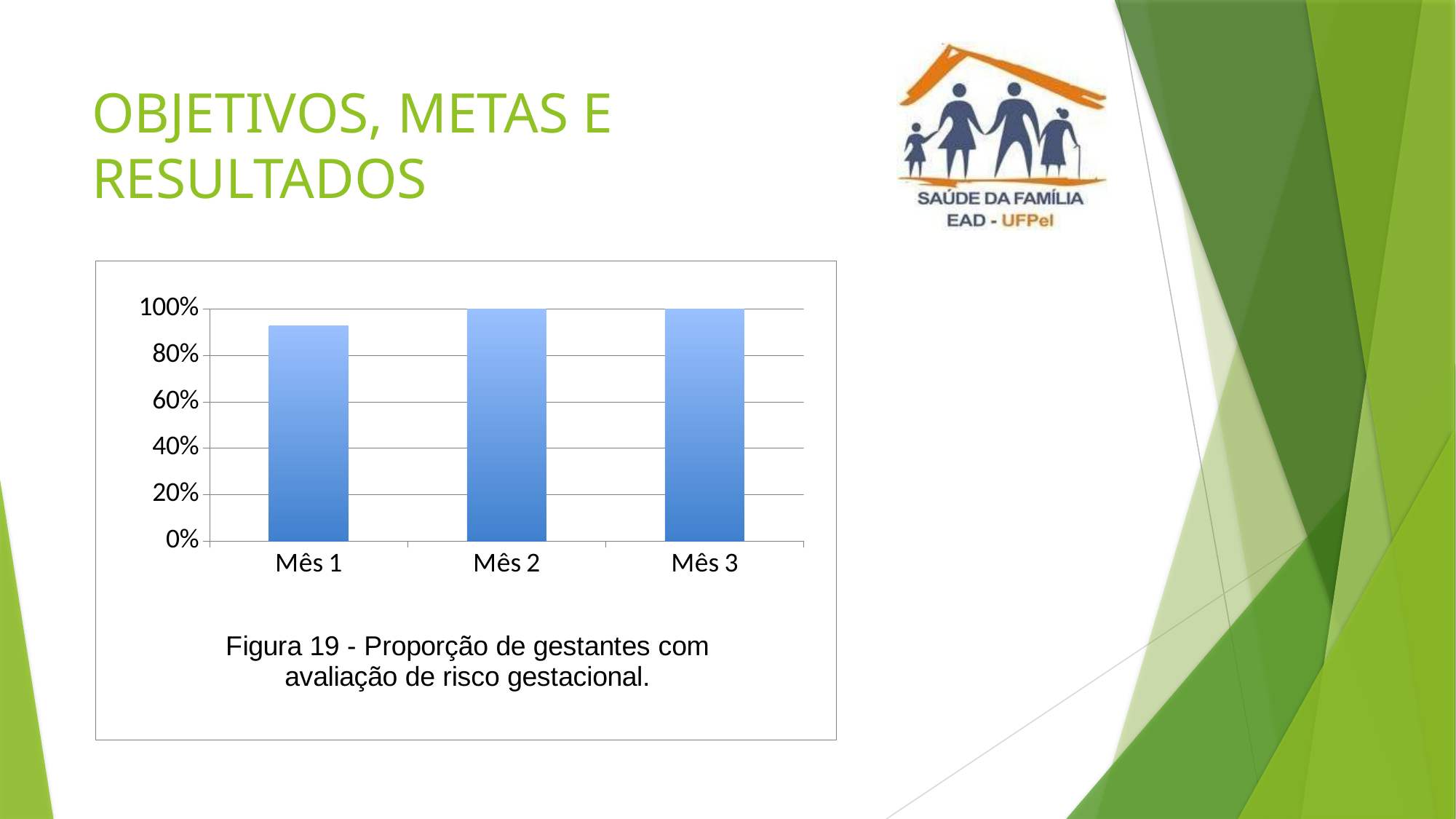
Is the value for Mês 1 greater or less than 80%? greater Do the values rise or fall from Mês 1 to Mês 3? rise What kind of chart is shown on the slide? bar chart Which is larger, the value for Mês 1 or the value for Mês 2? Mês 2 What is the value for Mês 2? 100% How many months (categories) are plotted on the x axis? 3 Which month has the lowest value? Mês 1 What is the highest value shown on the y axis? 100% What is the figure number given in the caption below the chart? Figura 19 What is the value for Mês 3? 100% Is the value for Mês 1 greater or less than 100%? less